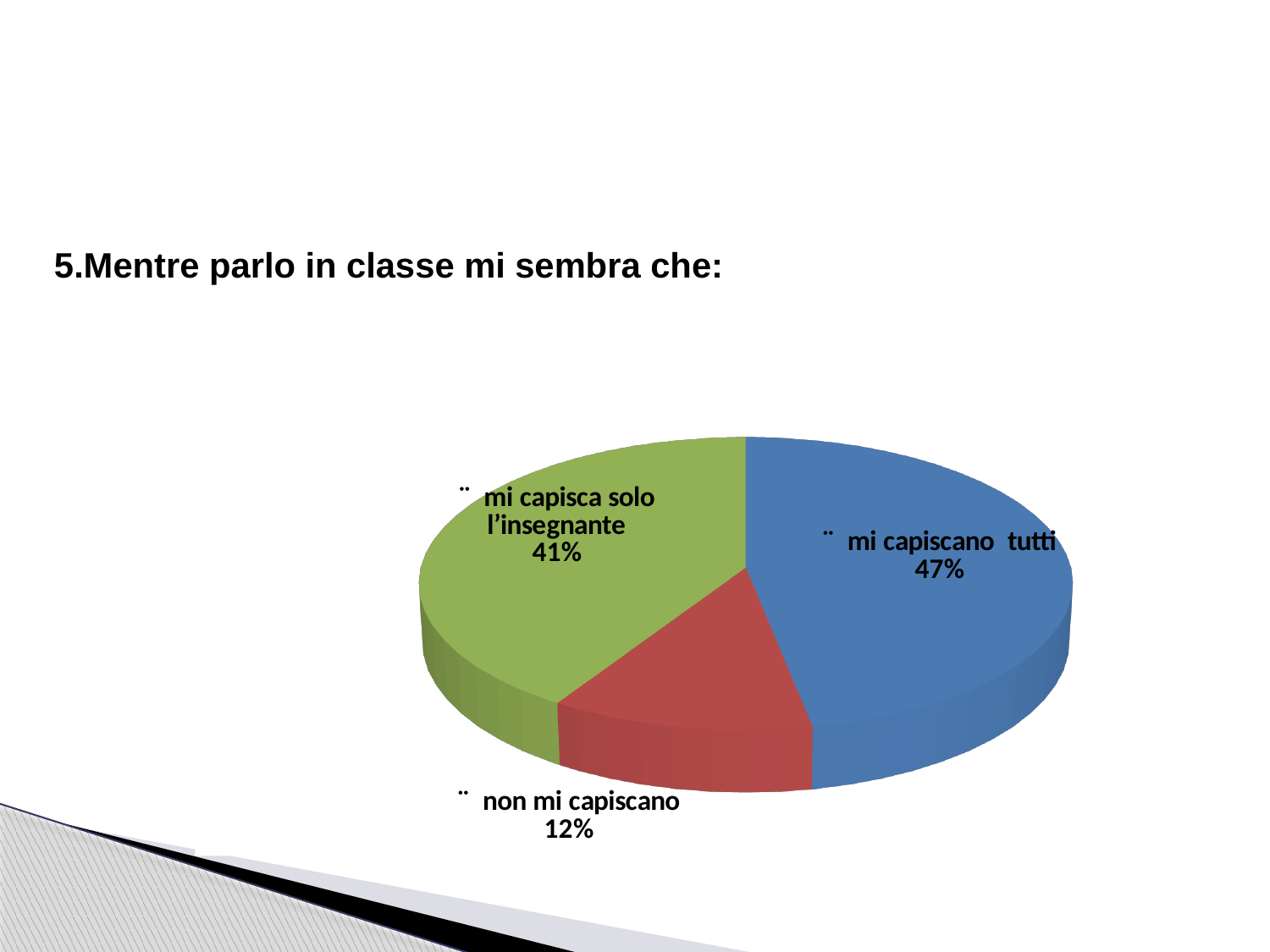
How many slices does the pie chart have? 3 Which slice of the pie is the smallest? non mi capiscano What is the difference in percentage points between "mi capisca solo l'insegnante" and "non mi capiscano"? 29 What percentage of the pie is labelled "mi capiscano tutti"? 47% What percentage of the pie is labelled "mi capisca solo l'insegnante"? 41% What is the title text above the chart? 5.Mentre parlo in classe mi sembra che: Which is larger, the share for "mi capisca solo l'insegnante" or the share for "non mi capiscano"? mi capisca solo l'insegnante What colour is the slice for "non mi capiscano"? red What percentage of the pie is labelled "non mi capiscano"? 12% Which slice of the pie is the largest? mi capiscano tutti What kind of chart is shown on the slide? pie chart What is the difference in percentage points between "mi capiscano tutti" and "mi capisca solo l'insegnante"? 6